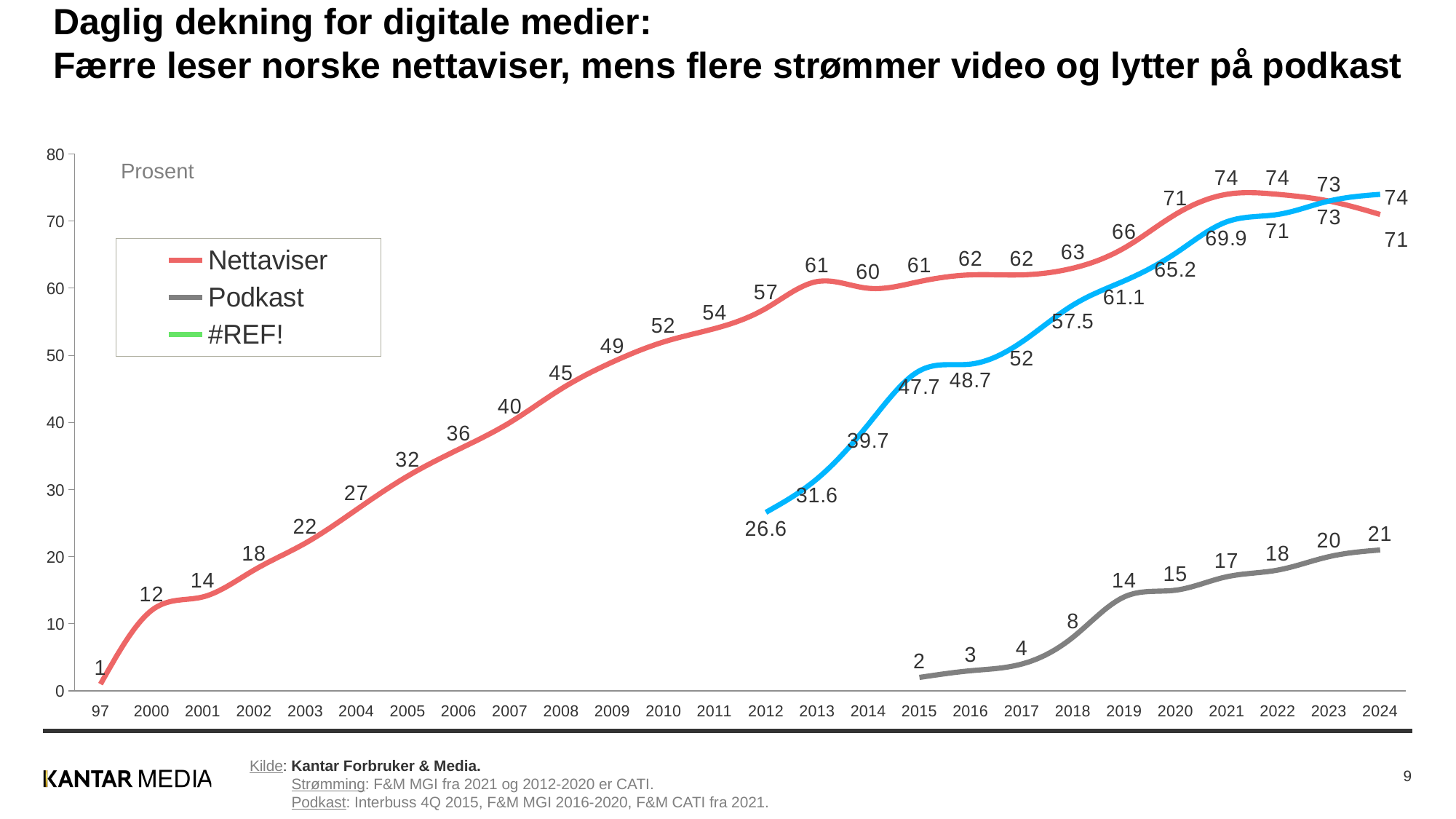
Does the Podkast line rise or fall from 2015 to 2024? rise How many series does the legend list? 3 What is the Podkast value for 2019? 14 Is the Nettaviser value for 2005 greater or less than 30? greater What is the Nettaviser value for 2024? 71 What is the Nettaviser value for 2010? 52 How many years are shown on the x axis? 26 Which is larger, the Nettaviser value for 2013 or for 2014? 2013 What is the highest value reached by the Nettaviser line? 74 What kind of chart is shown on the slide? line chart What is the difference between the Nettaviser and Podkast values in 2024? 50 In which year is the Podkast value lowest? 2015